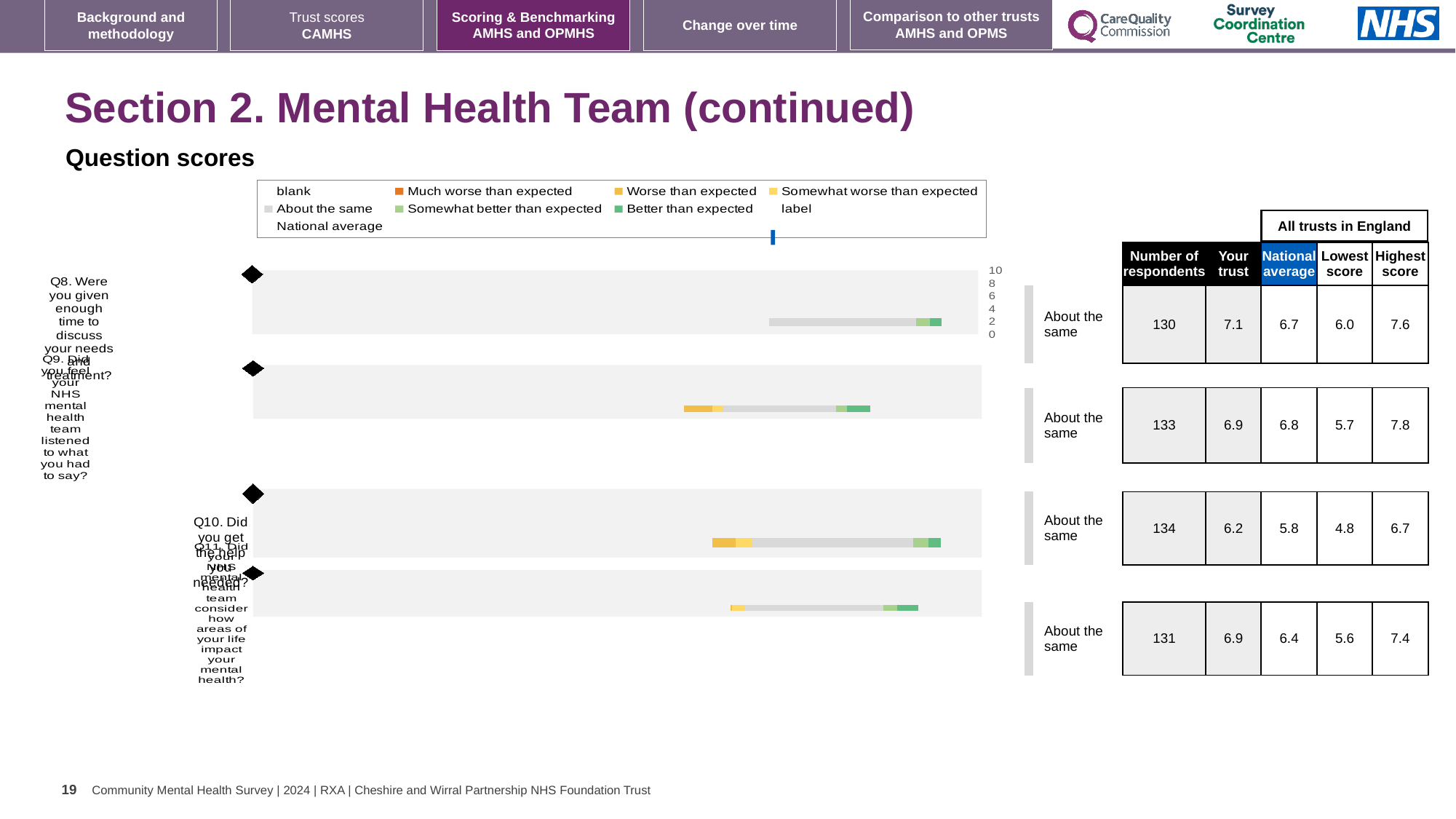
What kind of chart is used to show the question scores on this slide? bar chart Which question has the lowest 'Your trust' score in the table beside the chart? Q10 What benchmark category is shown next to each of the four question bars? About the same Which question has the highest 'Your trust' score in the table beside the chart? Q8 What is the difference between the 'Your trust' score and the national average for Q8? 0.4 In the table beside the chart, what is the national average for Q10? 5.8 What colour does the legend use for 'Much worse than expected'? orange How many survey questions (categories) are plotted in the question scores chart? 4 In the table beside the chart, what is the 'Your trust' score for Q8? 7.1 What is the highest score among all trusts in England for Q9? 7.8 For Q11, which is larger: the 'Your trust' score or the national average? Your trust In the table beside the chart, how many respondents answered Q9? 133